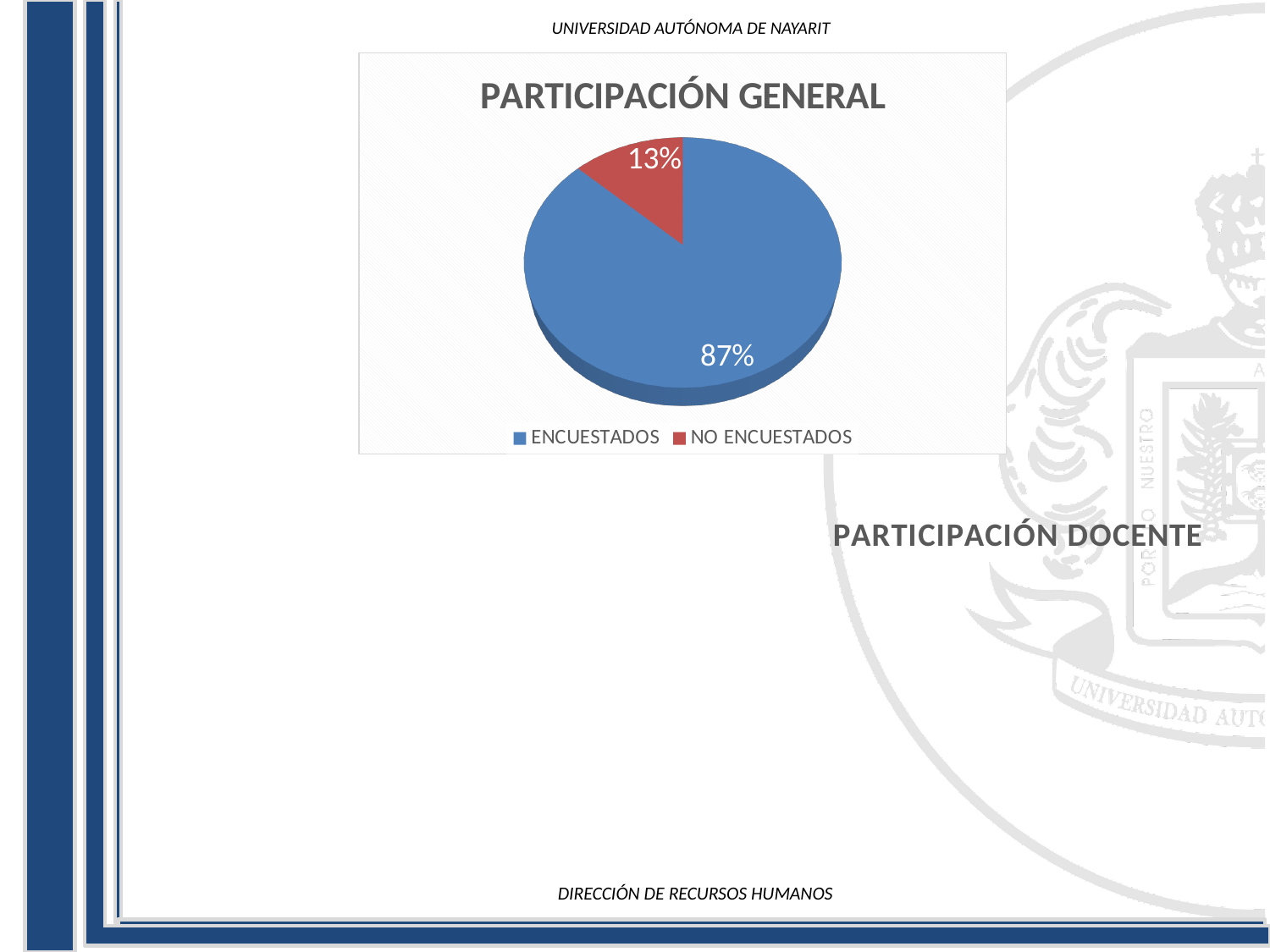
What is the title of the chart? PARTICIPACIÓN GENERAL How many entries does the legend list? 2 Which is larger, the ENCUESTADOS slice or the NO ENCUESTADOS slice? ENCUESTADOS What share of the pie does ENCUESTADOS represent? 87% What kind of chart is shown on the slide? Pie chart What is the difference in percentage points between ENCUESTADOS and NO ENCUESTADOS? 74 What share of the pie does NO ENCUESTADOS represent? 13% What colour is the NO ENCUESTADOS slice? Red Which category has the largest slice of the pie? ENCUESTADOS Which category has the smallest slice of the pie? NO ENCUESTADOS How many slices does the pie chart have? 2